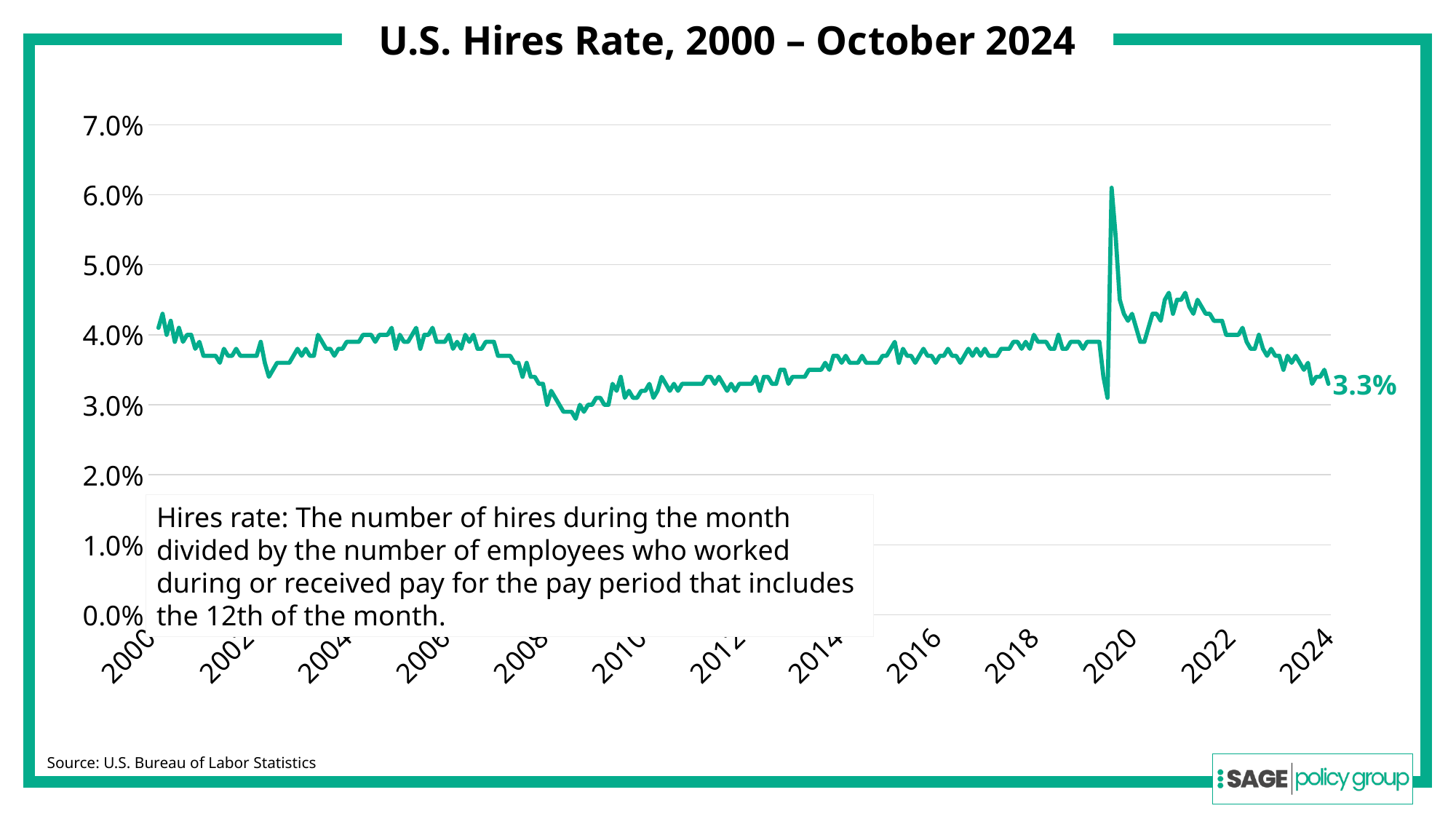
Does the hires rate generally rise or fall between 2009 and 2019? rise In which year does the hires rate reach its highest peak? 2020 What is the title of the chart? U.S. Hires Rate, 2000 – October 2024 Is the lowest value of the hires rate, around 2009, greater or less than 3.0%? less Is the peak value of the hires rate in 2020 greater or less than 5.0%? greater How many year labels are shown on the x axis? 13 What is the U.S. hires rate labeled at the end of the line, for October 2024? 3.3% Does the hires rate rise or fall between 2022 and October 2024? fall Which is larger, the hires rate at the start of 2000 or the hires rate in October 2024? start of 2000 What kind of chart is shown on the slide? line chart What source is cited for the chart data? U.S. Bureau of Labor Statistics